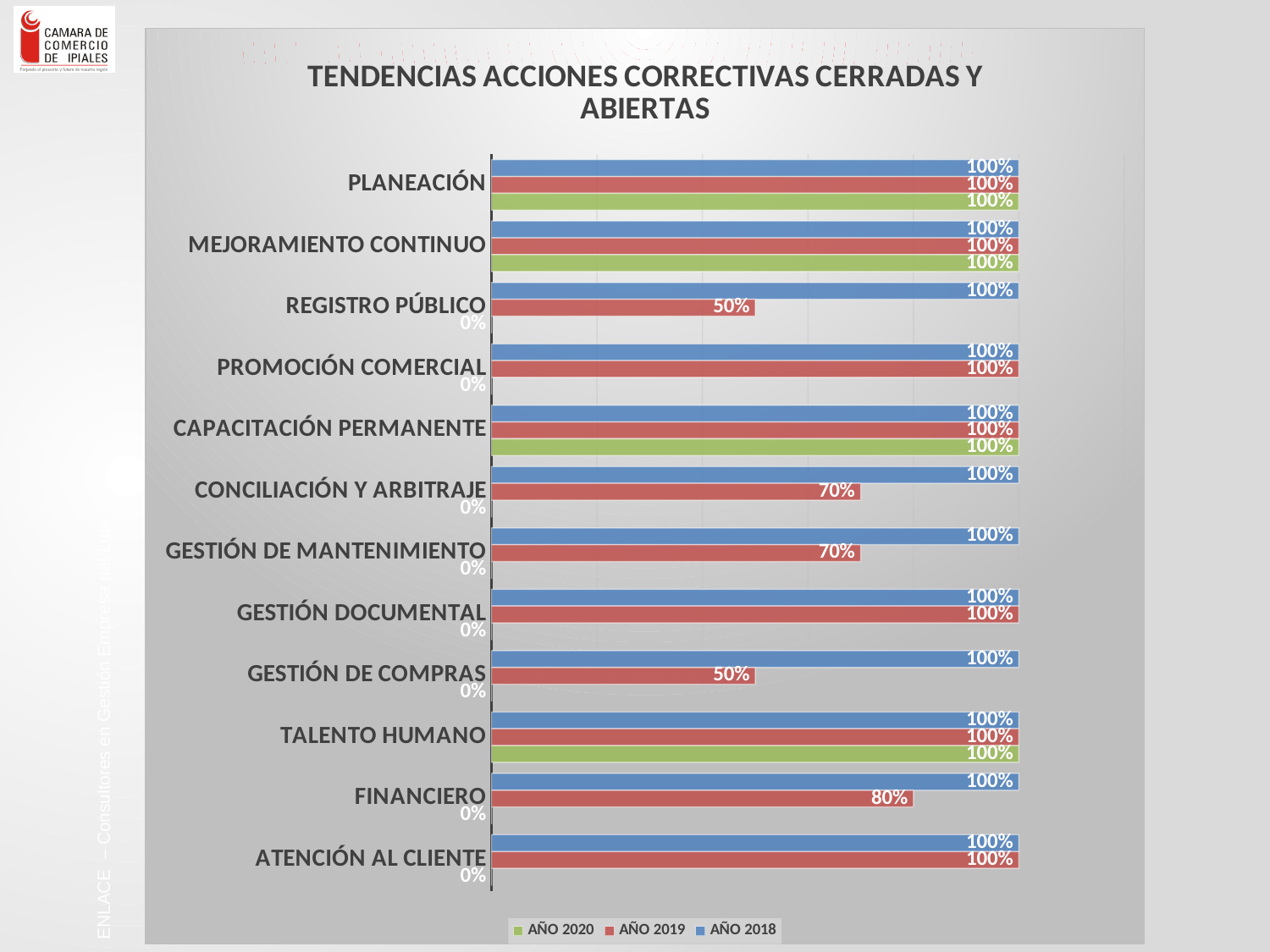
What is the title of the chart? TENDENCIAS ACCIONES CORRECTIVAS CERRADAS Y ABIERTAS What type of chart is shown on the slide? Bar chart How many categories are shown on the chart? 12 Which is larger for GESTIÓN DE COMPRAS: the AÑO 2018 value or the AÑO 2019 value? AÑO 2018 How many series does the legend list? 3 What is the difference between the AÑO 2018 and AÑO 2019 values for GESTIÓN DE MANTENIMIENTO? 30% What is the value for CONCILIACIÓN Y ARBITRAJE in AÑO 2020? 0% Which colour represents AÑO 2018 in the legend? Blue What is the value for REGISTRO PÚBLICO in AÑO 2019? 50% What is the value for TALENTO HUMANO in AÑO 2020? 100% What is the value for FINANCIERO in AÑO 2019? 80% Which category has the lowest AÑO 2019 value? REGISTRO PÚBLICO and GESTIÓN DE COMPRAS (50%)